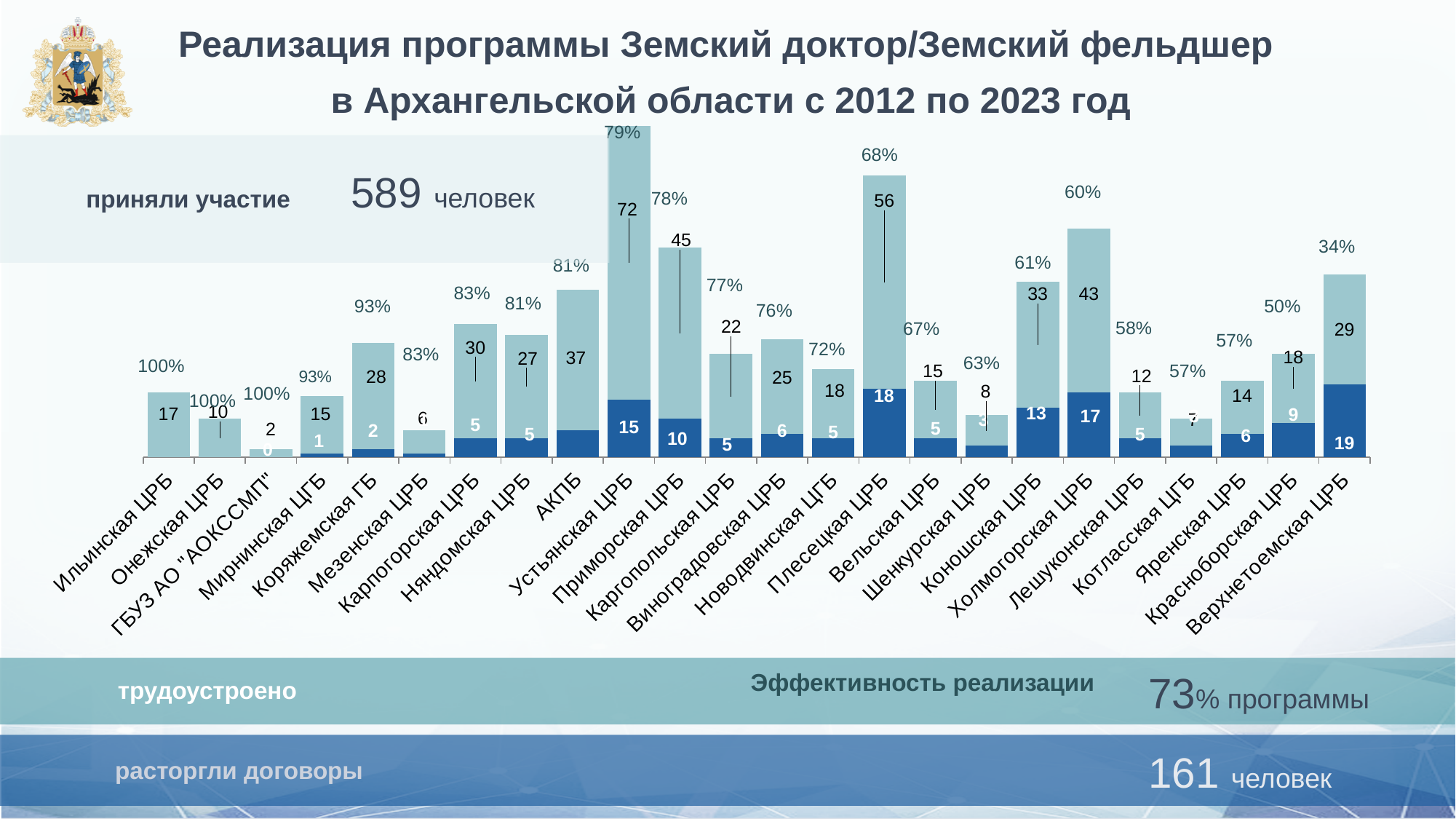
What is the dark-blue (расторгли договоры) value for Верхнетоемская ЦРБ? 19 Which hospital has the highest light-blue (трудоустроено) value? Устьянская ЦРБ What is the light-blue (трудоустроено) value for Устьянская ЦРБ? 72 Do the percentages shown above the bars generally rise or fall from left to right along the x axis? fall Which has a larger light-blue value: Холмогорская ЦРБ or Коношская ЦРБ? Холмогорская ЦРБ What is the difference between the light-blue values for Плесецкая ЦРБ (56) and Приморская ЦРБ (45)? 11 How many hospitals (categories) are shown along the x axis of the chart? 24 What kind of chart is shown on the slide? bar chart What is the total of the stacked bar for Устьянская ЦРБ (72 + 15)? 87 What percentage is shown above the bar for Ильинская ЦРБ? 100% What percentage is shown above the bar for Плесецкая ЦРБ? 68% Which hospital has the lowest percentage shown above its bar? Верхнетоемская ЦРБ